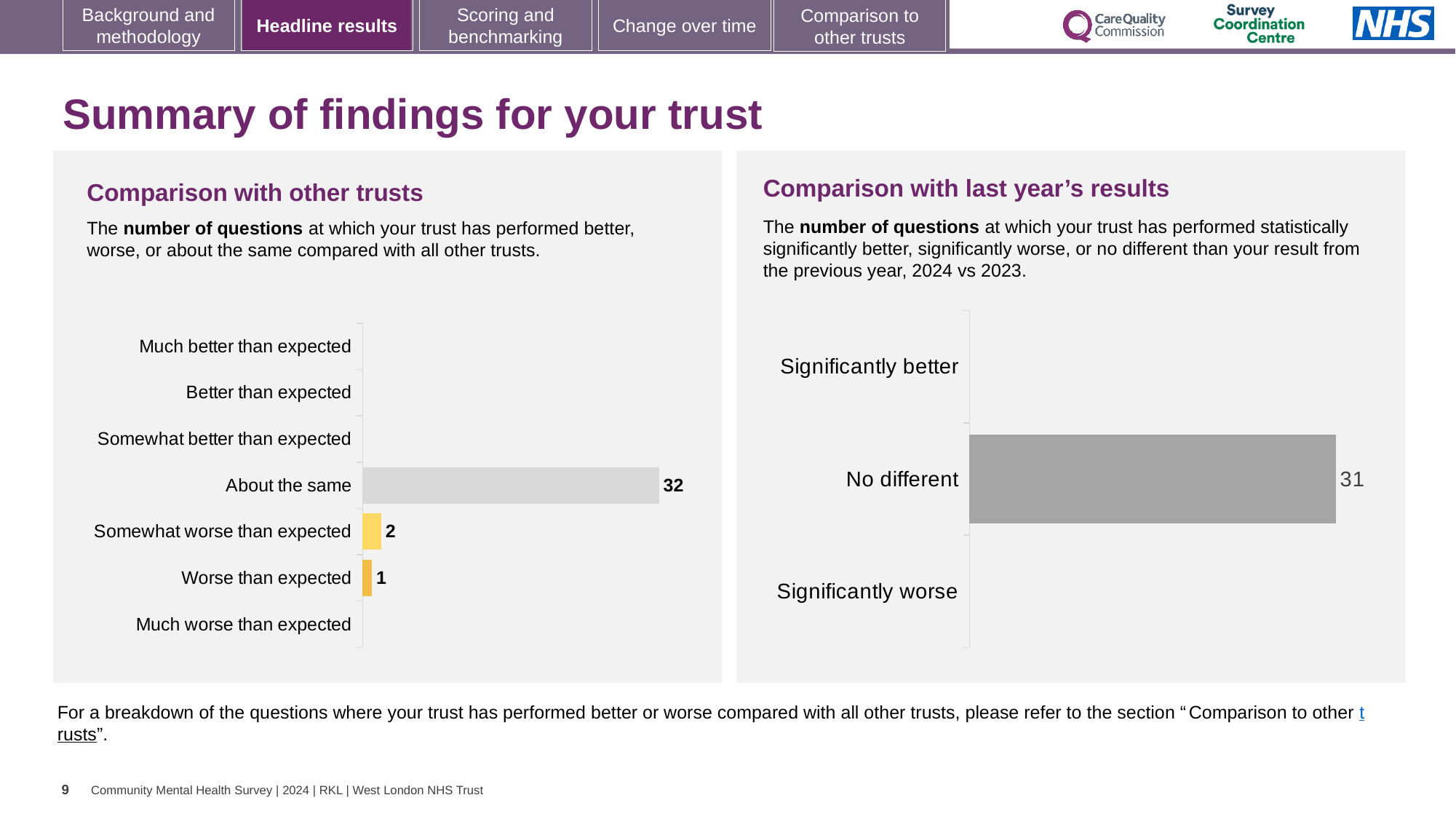
What is the title of the chart on the left side of the slide? Comparison with other trusts In the 'Comparison with other trusts' chart, which is larger: the value for 'Somewhat worse than expected' or the value for 'Worse than expected'? Somewhat worse than expected How many categories are shown on the y axis of the 'Comparison with last year's results' chart? 3 In the 'Comparison with other trusts' chart, what is the value for 'Somewhat worse than expected'? 2 In the 'Comparison with last year's results' chart, what is the value for 'No different'? 31 How many categories are shown on the y axis of the 'Comparison with other trusts' chart? 7 In the 'Comparison with other trusts' chart, what is the value for 'About the same'? 32 What kind of chart is the 'Comparison with last year's results' chart? Bar chart In the 'Comparison with other trusts' chart, what is the value for 'Worse than expected'? 1 In the 'Comparison with other trusts' chart, which category has the highest value? About the same In the 'Comparison with last year's results' chart, which category has the highest value? No different In the 'Comparison with other trusts' chart, what is the difference between the values for 'About the same' and 'Somewhat worse than expected'? 30